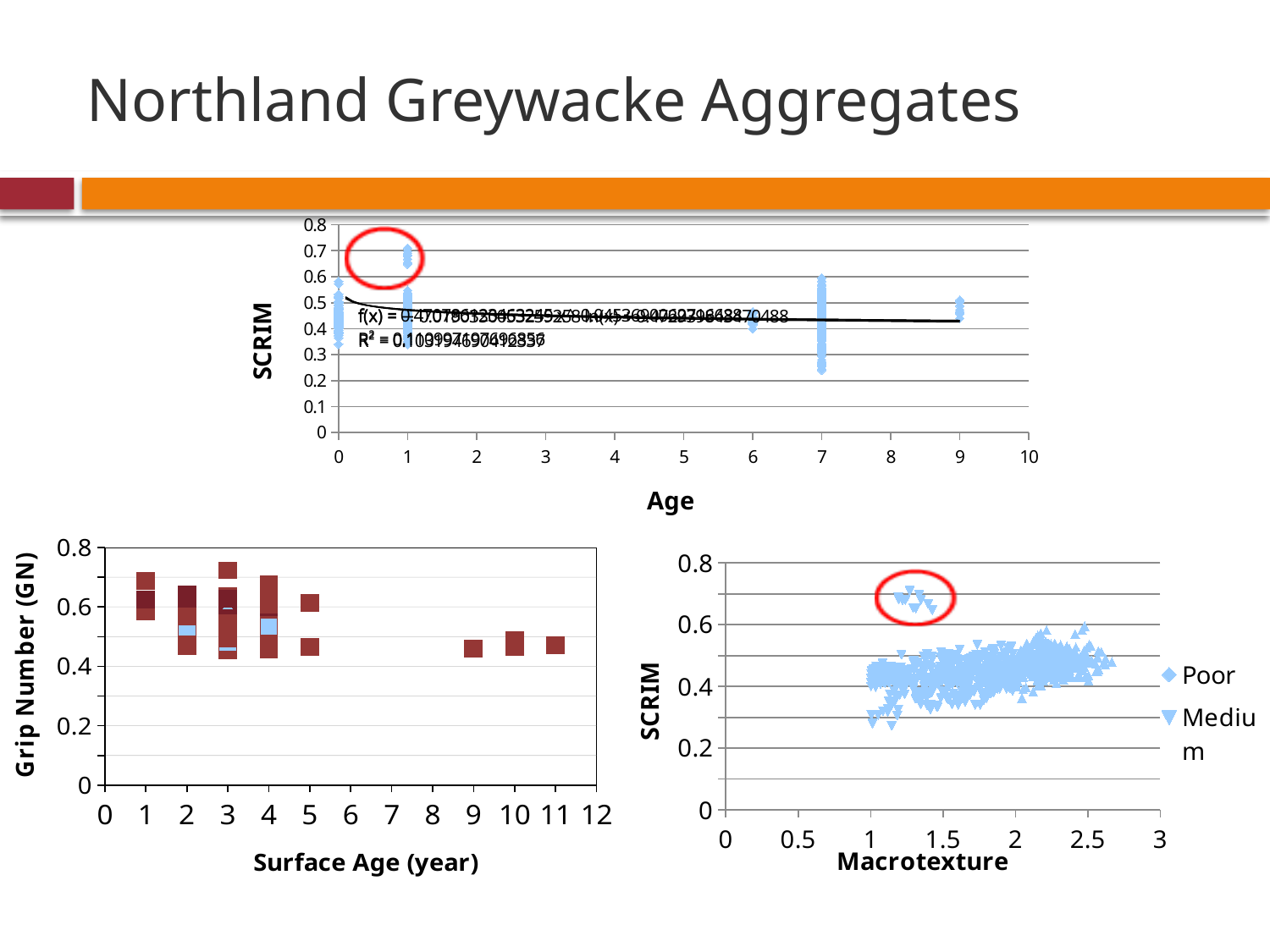
In the top chart, how many distinct Age values have data points plotted? 5 In the top chart, is the lowest SCRIM value at Age 7 greater or less than 0.3? less What kind of chart is the top chart (SCRIM vs Age)? scatter chart In the top chart, is the highest SCRIM value at Age 1 (the circled points) greater or less than 0.6? greater In the bottom-right chart, do SCRIM values generally rise or fall as Macrotexture increases? rise In the bottom-left chart, how many Surface Age values have data plotted? 8 In the bottom-left chart, do Grip Number values generally rise or fall as Surface Age increases? fall In the top chart, what is the label of the x axis? Age In the bottom-left chart, what is the label of the y axis? Grip Number (GN) In the bottom-right chart (SCRIM vs Macrotexture), how many series does the legend list? 2 In the bottom-right chart, is the SCRIM value of the circled points greater or less than 0.6? greater